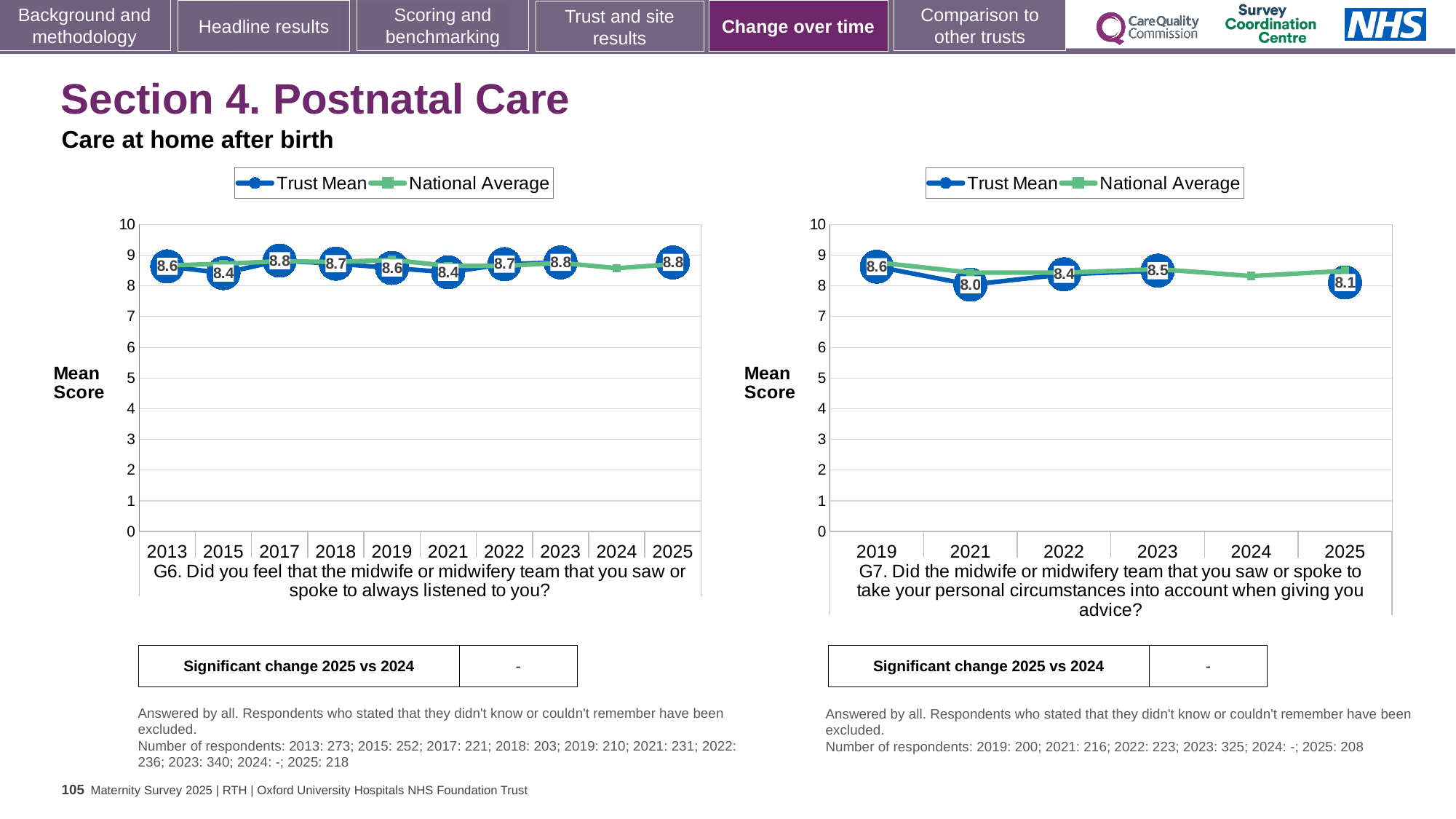
In the G6 chart (left), is the National Average value for 2024 greater or less than 8? greater In the G7 chart (right), what is the difference between the Trust Mean scores for 2019 and 2021? 0.6 In the G7 chart (right), which year has the lowest Trust Mean score? 2021 How many years are shown on the x axis of the G6 chart (left)? 10 What type of chart is the G6 chart (left)? Line chart In the G6 chart (left), what is the Trust Mean score for 2021? 8.4 In the G6 chart (left), which is larger, the Trust Mean score for 2015 or for 2017? 2017 In the G7 chart (right), what is the Trust Mean score for 2025? 8.1 In the G7 chart (right), which year has the highest Trust Mean score? 2019 In the G6 chart (left), what is the Trust Mean score for 2017? 8.8 How many series does the legend of the G7 chart (right) list? 2 In the G7 chart (right), what is the Trust Mean score for 2021? 8.0